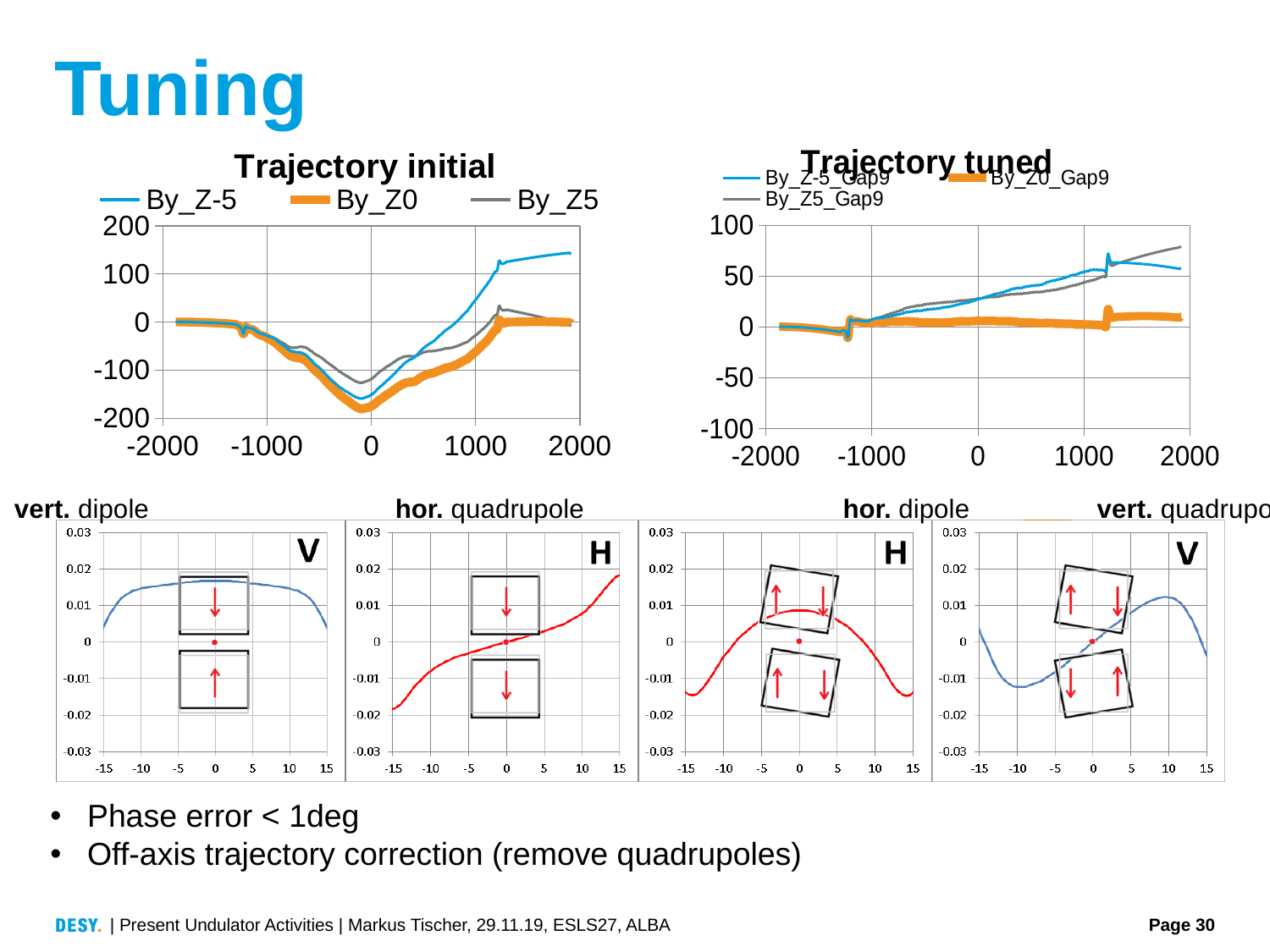
In the "Trajectory tuned" chart, does By_Z5_Gap9 rise or fall overall from x = -2000 to x = 2000? rise In the "Trajectory initial" chart, does By_Z0 rise or fall between x = -2000 and x = 0? fall In the "Trajectory initial" chart, which series has the higher value at x = 2000, By_Z-5 or By_Z5? By_Z-5 In the "Trajectory initial" chart, which series is drawn in orange? By_Z0 What are the legend entries of the "Trajectory tuned" chart? By_Z-5_Gap9, By_Z0_Gap9, By_Z5_Gap9 In the "Trajectory tuned" chart, which series has the higher value at x = 2000, By_Z5_Gap9 or By_Z0_Gap9? By_Z5_Gap9 How many series does the legend of the "Trajectory tuned" chart list? 3 In the "Trajectory tuned" chart, is the value of By_Z5_Gap9 at x = 2000 greater or less than 50? greater In the "Trajectory initial" chart, is the value of By_Z-5 at x = 2000 greater or less than 100? greater What kind of chart is the "Trajectory initial" chart? line chart In the "Trajectory initial" chart, is the lowest value of By_Z0 greater or less than -100? less How many series does the legend of the "Trajectory initial" chart list? 3